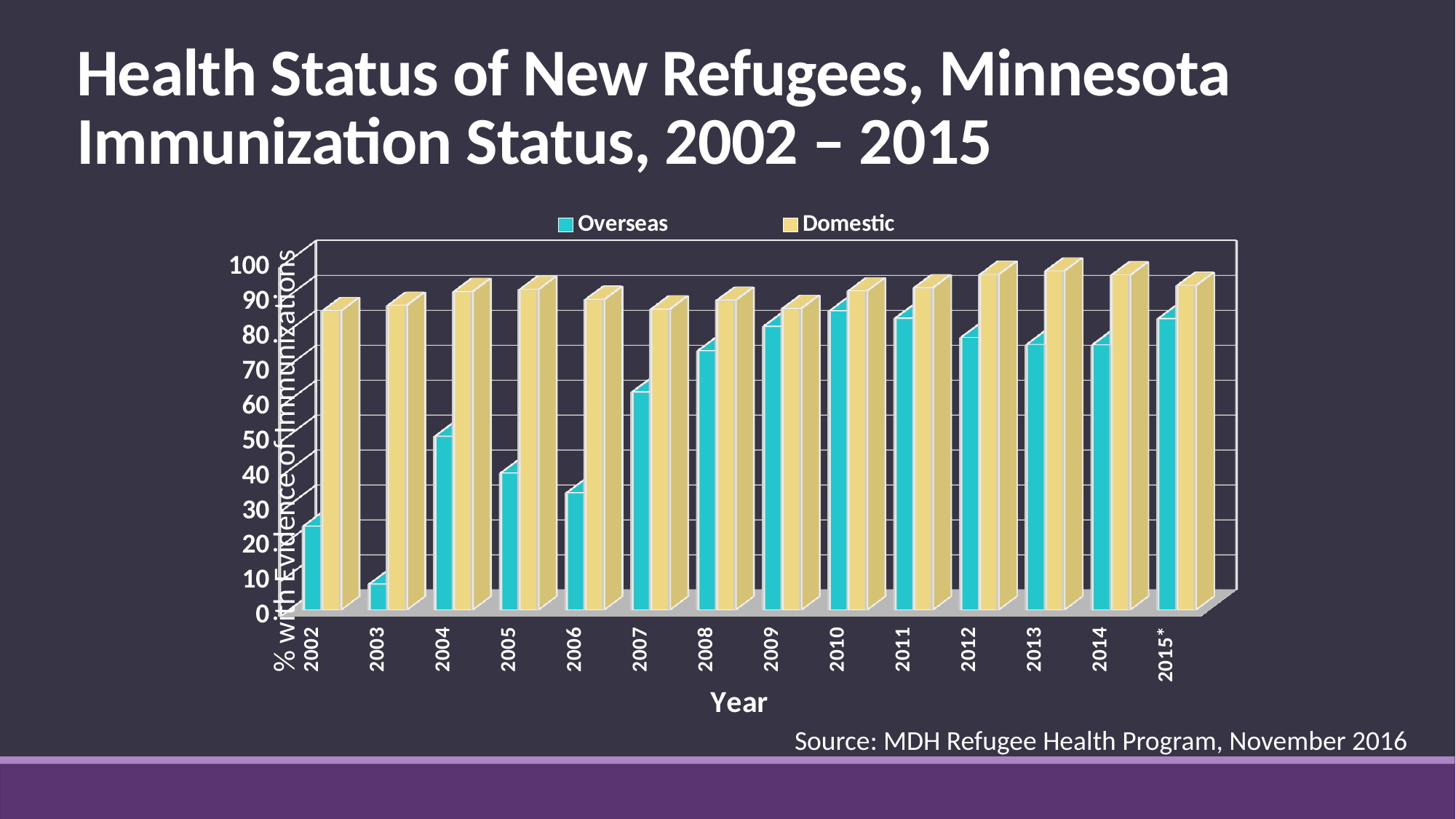
Which year has the lowest Overseas value? 2003 Which is larger, the Overseas value for 2003 or for 2004? 2004 Is the Overseas value for 2007 greater or less than 50? greater Do the Overseas values rise or fall from 2006 to 2010? rise How many series does the legend list? 2 Is the Domestic value for 2013 greater or less than 90? greater Is the Overseas value for 2003 greater or less than 20? less What kind of chart is shown on the slide? bar chart In 2002, which is larger, the Overseas value or the Domestic value? Domestic What is the title of the x axis? Year How many years are shown on the x axis? 14